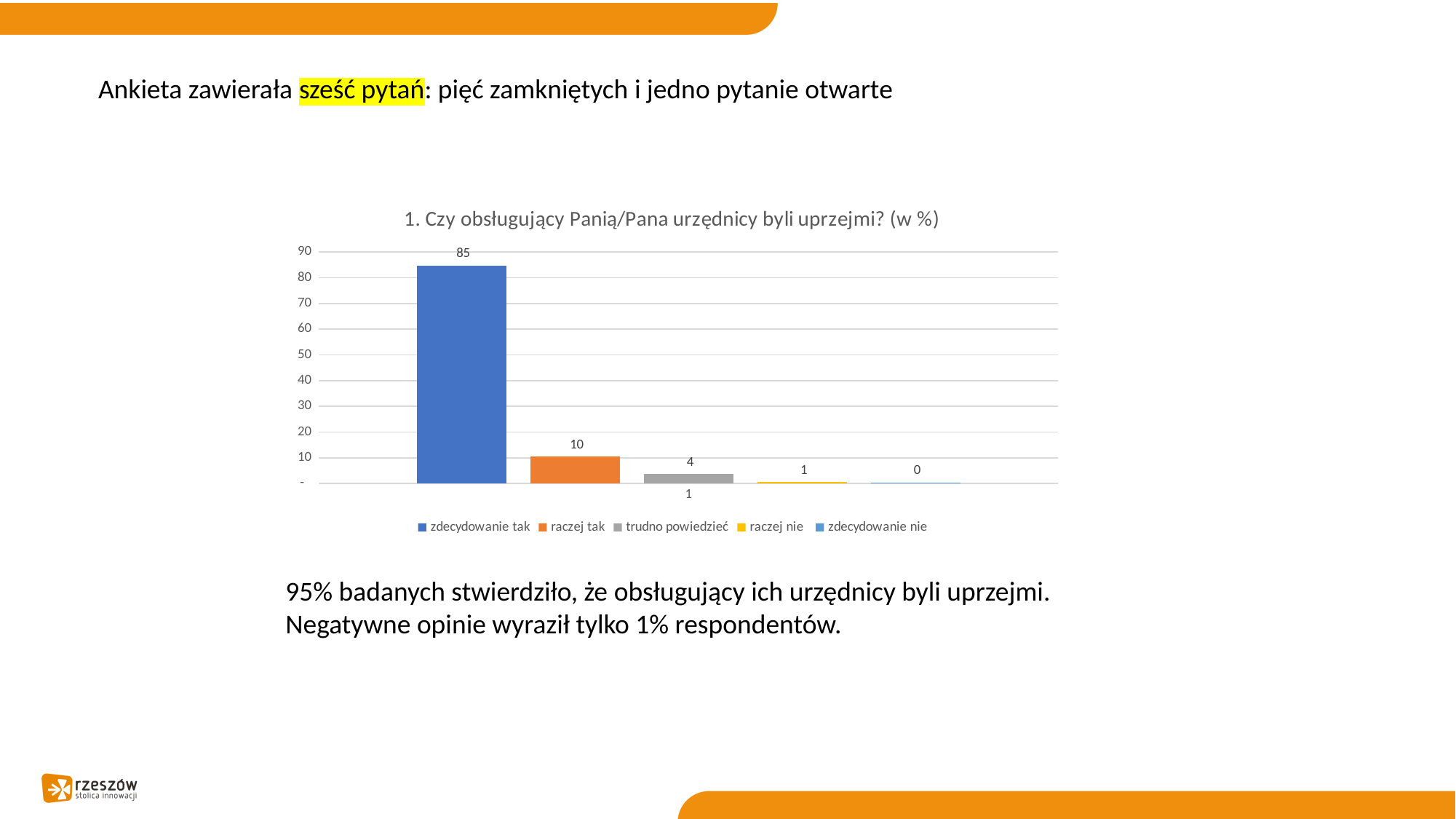
What kind of chart is shown on the slide? bar chart How many series does the legend list? 5 What is the difference between the values for "zdecydowanie tak" and "raczej tak"? 75 Which response has the highest value? zdecydowanie tak What value is shown for "zdecydowanie tak"? 85 What value is shown for "trudno powiedzieć"? 4 What value is shown for "raczej tak"? 10 What value is shown for "zdecydowanie nie"? 0 Which response has the lowest value? zdecydowanie nie Is the value for "zdecydowanie tak" greater or less than 80? greater What is the title of the chart? 1. Czy obsługujący Panią/Pana urzędnicy byli uprzejmi? (w %) Which is larger, the value for "raczej tak" or the value for "trudno powiedzieć"? raczej tak